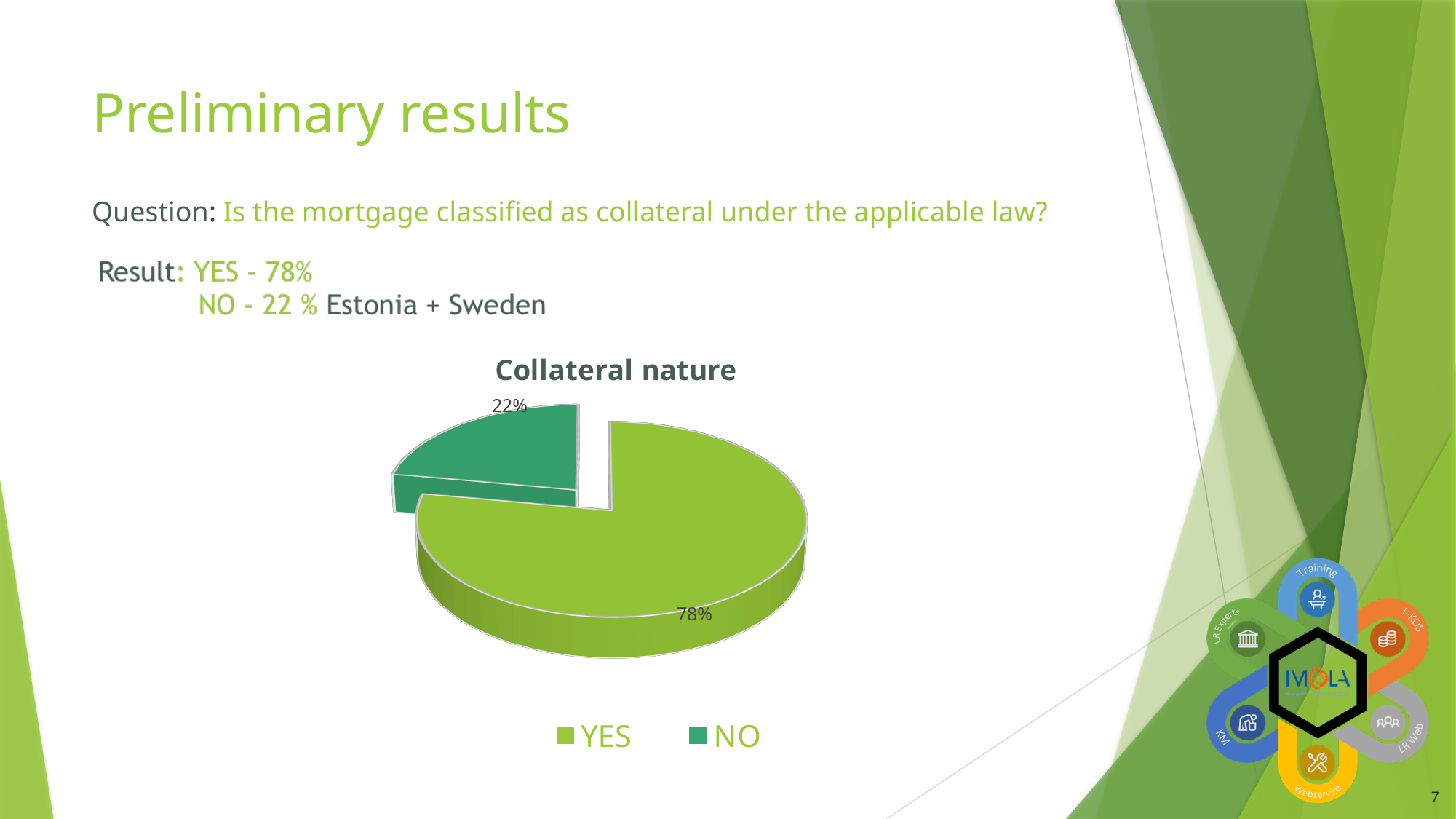
Which slice of the pie is the smallest? NO Which legend entry is shown in the darker green colour? NO What share of the pie does YES represent? 78% How many slices does the pie chart have? 2 What share of the pie does NO represent? 22% What kind of chart is shown on the slide? pie chart Which slice of the pie is the largest? YES Which is larger, the YES slice or the NO slice? YES What is the title of the chart? Collateral nature How many entries does the legend list? 2 What is the difference in percentage points between the YES and NO slices? 56